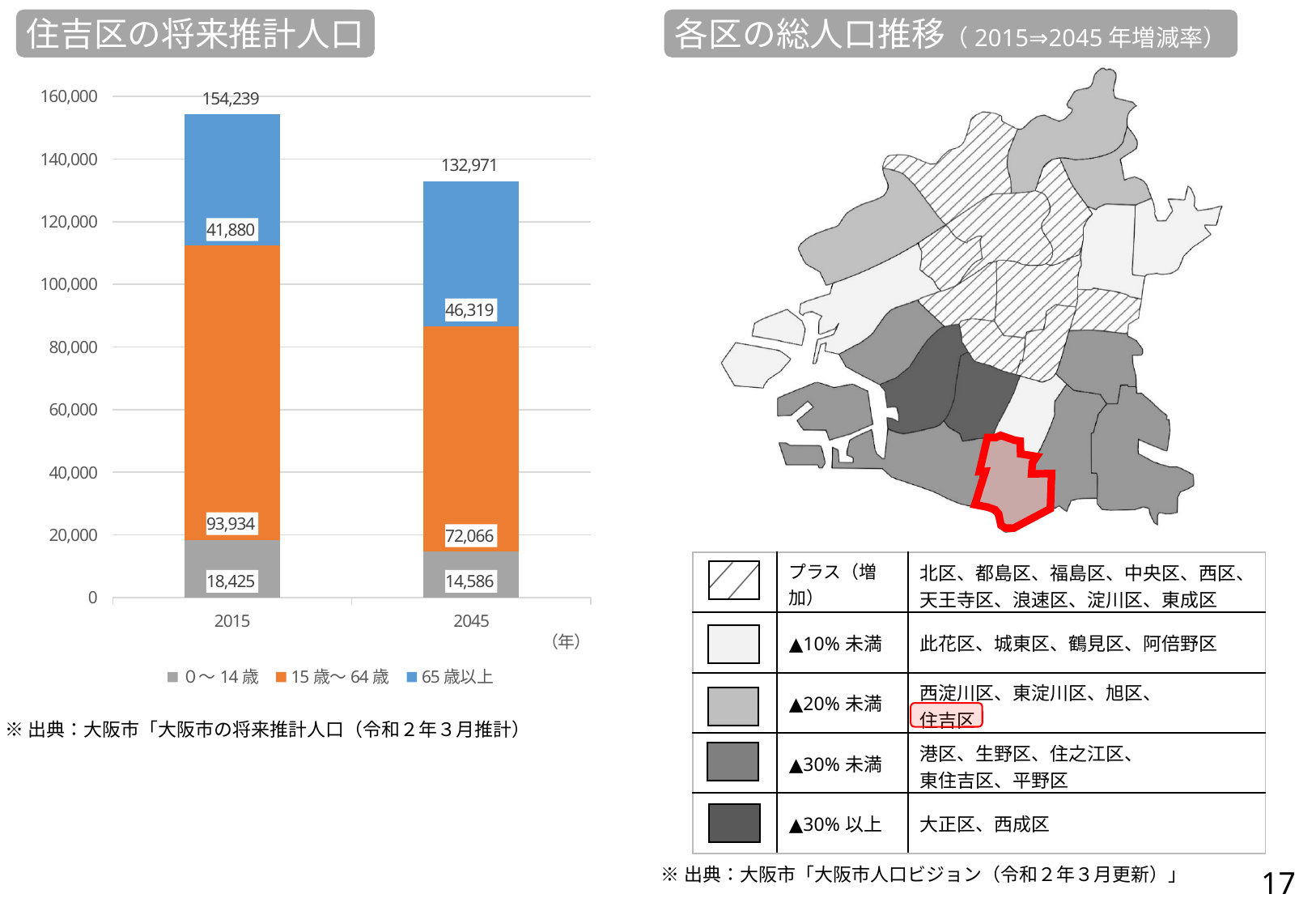
What is the value for the 0～14歳 series in 2015? 18,425 What is the value for the 15歳～64歳 series in 2015? 93,934 What kind of chart is shown on the left of the slide? stacked bar chart How many years (categories) are shown on the x axis? 2 How many series does the legend list? 3 What is the total of the stacked bar for 2015? 154,239 Does the total population rise or fall from 2015 to 2045? fall What is the title of the chart on the left of the slide? 住吉区の将来推計人口 What is the difference between the 15歳～64歳 values for 2015 and 2045? 21,868 What is the value for the 65歳以上 series in 2045? 46,319 What is the total of the stacked bar for 2045? 132,971 Which is larger, the 65歳以上 value in 2015 or in 2045? 2045